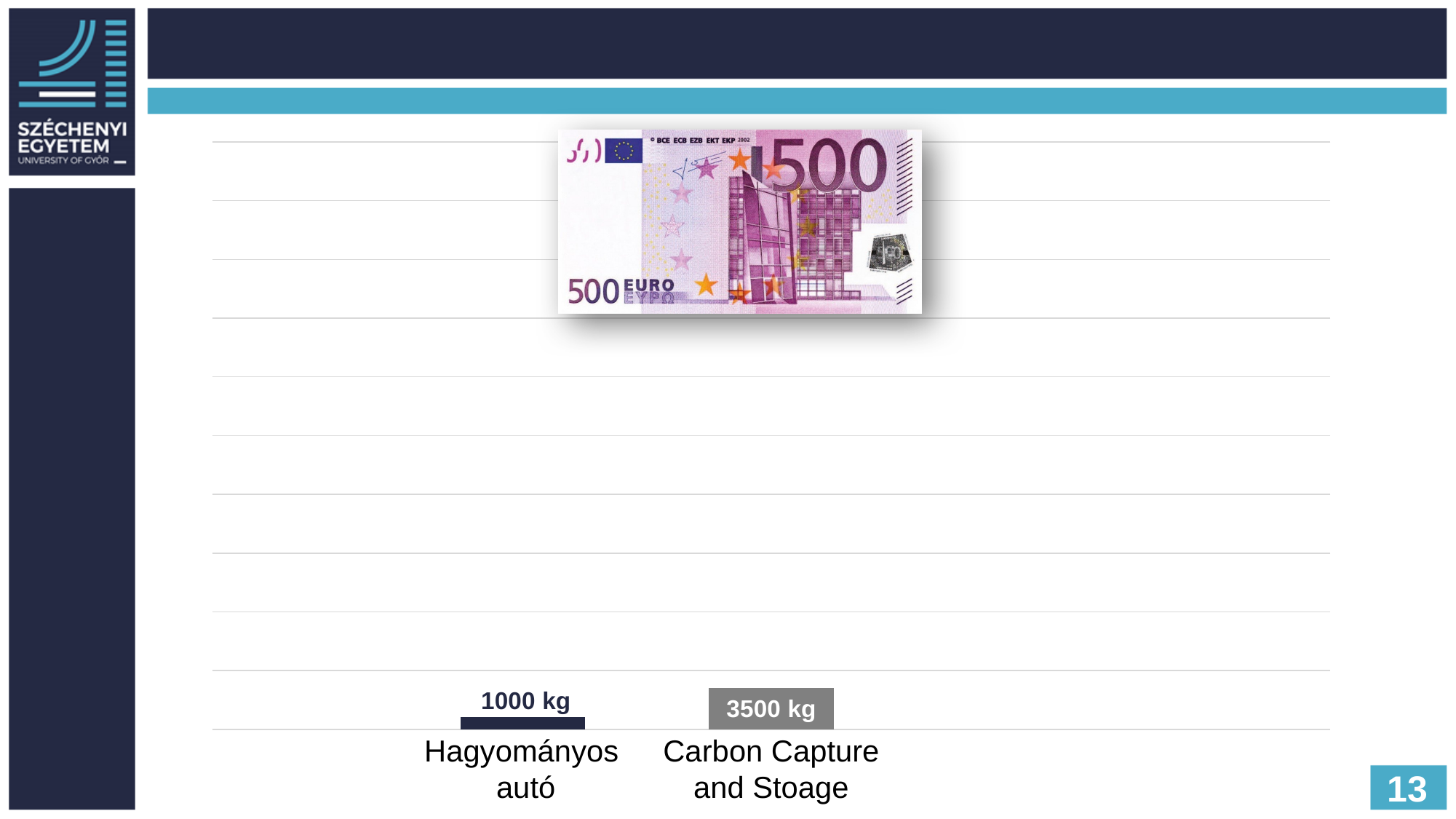
How many categories are shown in the chart? 2 What kind of chart is shown on the slide? Bar chart What colour is the bar for Hagyományos autó? Dark navy blue Which is larger, the value for Hagyományos autó or the value for Carbon Capture and Stoage? Carbon Capture and Stoage What colour is the bar for Carbon Capture and Stoage? Grey Which category has the highest value? Carbon Capture and Stoage What is the difference between the values for Carbon Capture and Stoage and Hagyományos autó? 2500 kg What is the value for Carbon Capture and Stoage? 3500 kg Which category has the lowest value? Hagyományos autó What is the value for Hagyományos autó? 1000 kg